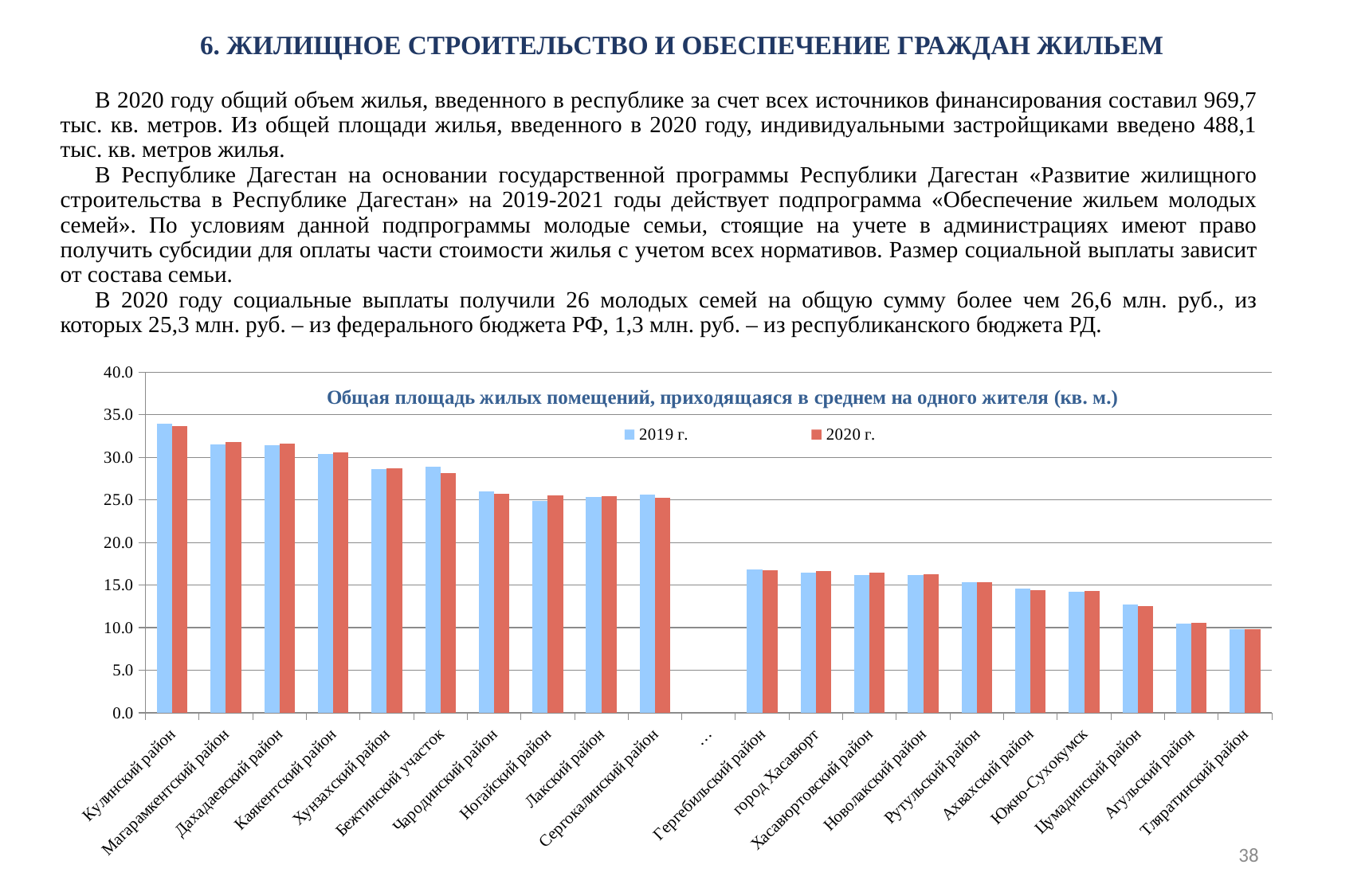
Which is larger for 2019 г.: Чародинский район or Ногайский район? Чародинский район Is the 2019 г. value for Кулинский район greater or less than 30? greater How many series does the chart legend list? 2 Which category has the highest value in the chart? Кулинский район Which category has the lowest value in the chart? Тляратинский район What is the title of the chart? Общая площадь жилых помещений, приходящаяся в среднем на одного жителя (кв. м.) Do the values generally rise or fall moving from left to right along the x axis? fall What kind of chart is shown on the slide? bar chart What are the two series named in the chart legend? 2019 г. and 2020 г. Is the 2019 г. value for Гергебильский район greater or less than 15? greater Is the 2019 г. value for Хунзахский район greater or less than 30? less